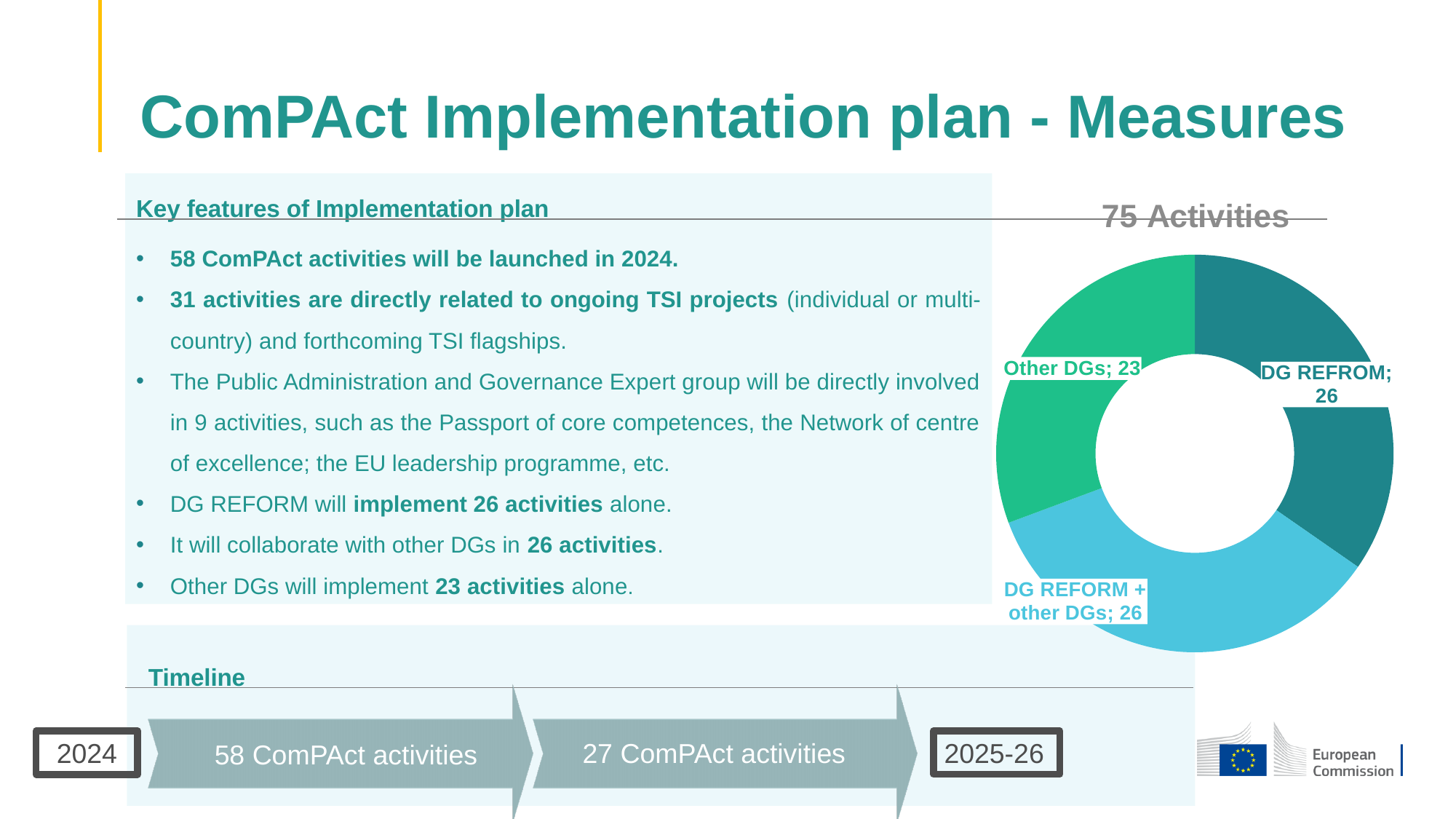
Which is larger, the DG REFROM slice or the Other DGs slice? DG REFROM Which slice has the smallest value? Other DGs What is the value for the DG REFROM slice? 26 What is the title of the chart on the slide? 75 Activities What is the value for the DG REFORM + other DGs slice? 26 What colour is the DG REFORM + other DGs slice? Light blue What share of the total activities does the Other DGs slice represent? 23 out of 75 How many slices does the chart have? 3 What is the total of all slices in the chart? 75 What is the difference between the DG REFROM value and the Other DGs value? 3 What is the value for the Other DGs slice? 23 What type of chart is shown on the slide? Doughnut (pie) chart